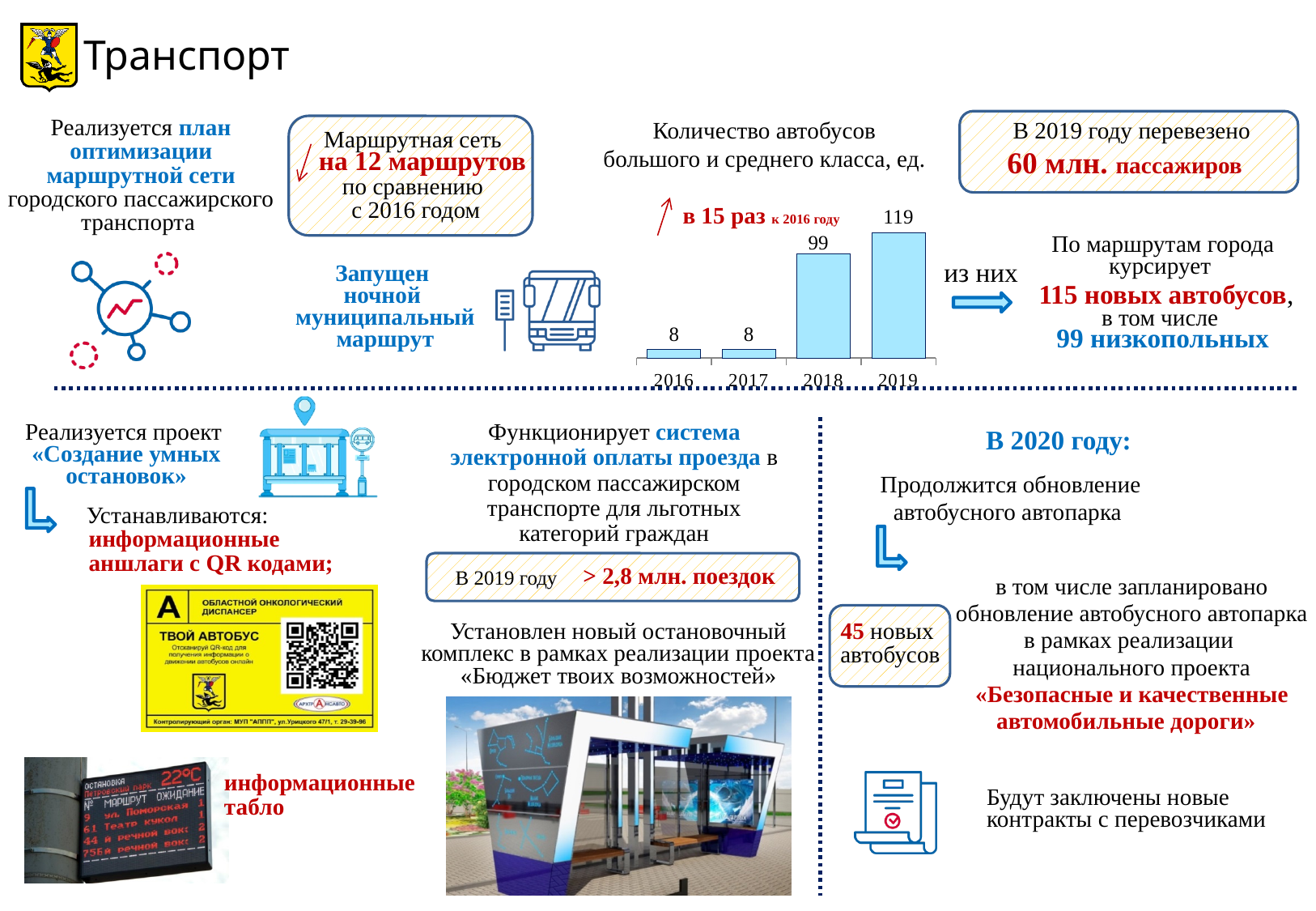
Which year has the highest value in the bus count chart? 2019 What is the value for 2019 in the chart 'Количество автобусов большого и среднего класса, ед.'? 119 What is the value for 2016 in the bus count chart? 8 What kind of chart is used to show the number of large and medium class buses? bar chart What is the difference between the 2019 and 2018 values in the bus count chart? 20 What is the title of the chart on the slide? Количество автобусов большого и среднего класса, ед. How many years are shown in the bus count chart? 4 Do the values in the bus count chart rise or fall from 2016 to 2019? rise What is the difference between the 2018 and 2017 values in the bus count chart? 91 What is the value for 2018 in the bus count chart? 99 In the bus count chart, which is larger: the value for 2018 or the value for 2019? 2019 What is the value for 2017 in the bus count chart? 8